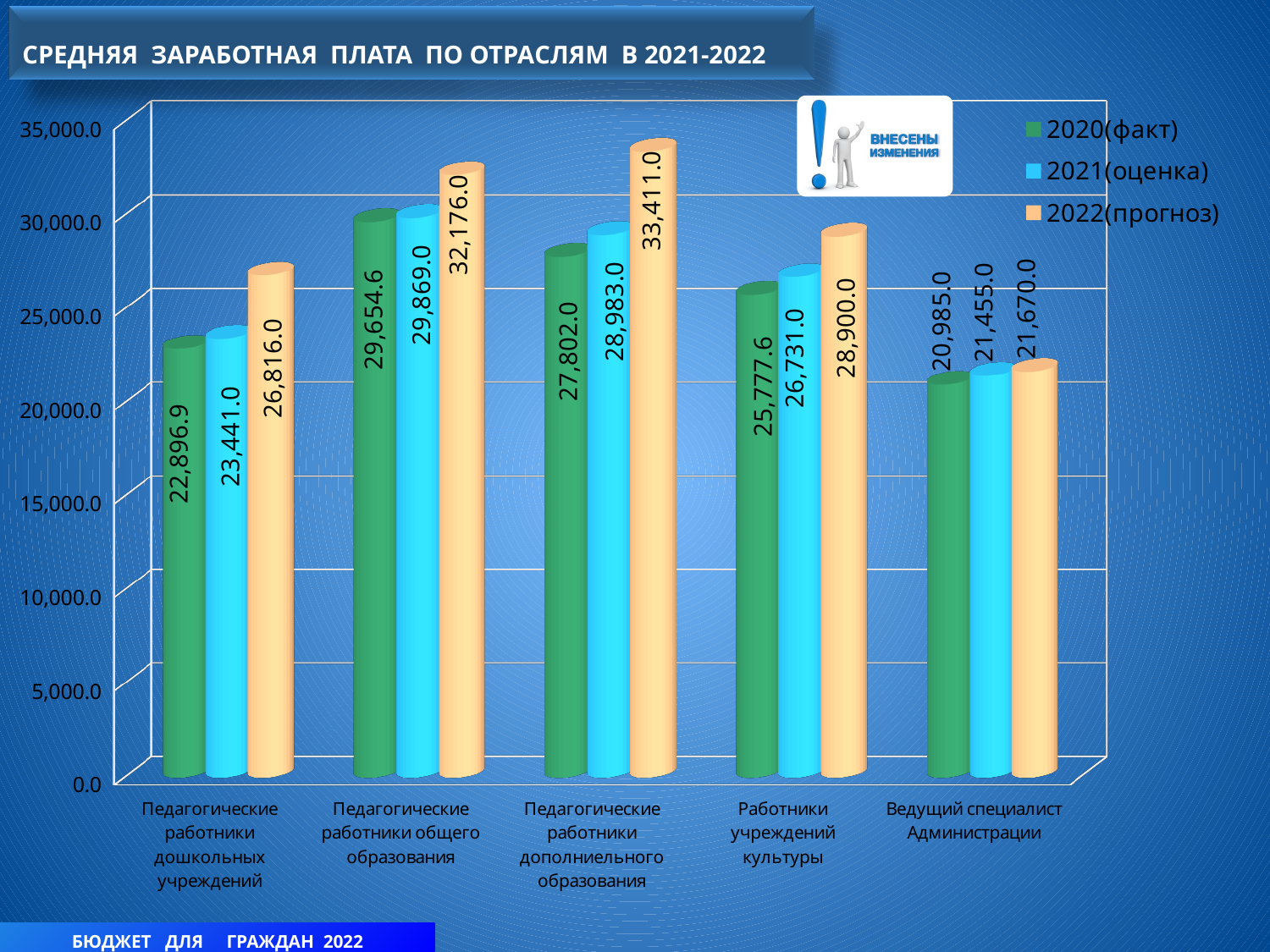
What is the 2020(факт) value for Работники учреждений культуры? 25,777.6 How many categories are shown on the x axis? 5 What is the 2022(прогноз) value for Педагогические работники дополниельного образования? 33,411.0 What is the title of the chart? СРЕДНЯЯ ЗАРАБОТНАЯ ПЛАТА ПО ОТРАСЛЯМ В 2021-2022 What is the difference between the 2022(прогноз) and 2021(оценка) values for Педагогические работники дошкольных учреждений? 3,375.0 Do the values for Ведущий специалист Администрации rise or fall from 2020(факт) to 2022(прогноз)? Rise Which is larger: the 2022(прогноз) value for Педагогические работники общего образования or for Работники учреждений культуры? Педагогические работники общего образования How many series does the legend list? 3 What is the 2021(оценка) value for Ведущий специалист Администрации? 21,455.0 Which category has the highest 2022(прогноз) value? Педагогические работники дополниельного образования Which category has the lowest 2020(факт) value? Ведущий специалист Администрации What type of chart is shown on the slide? Bar chart